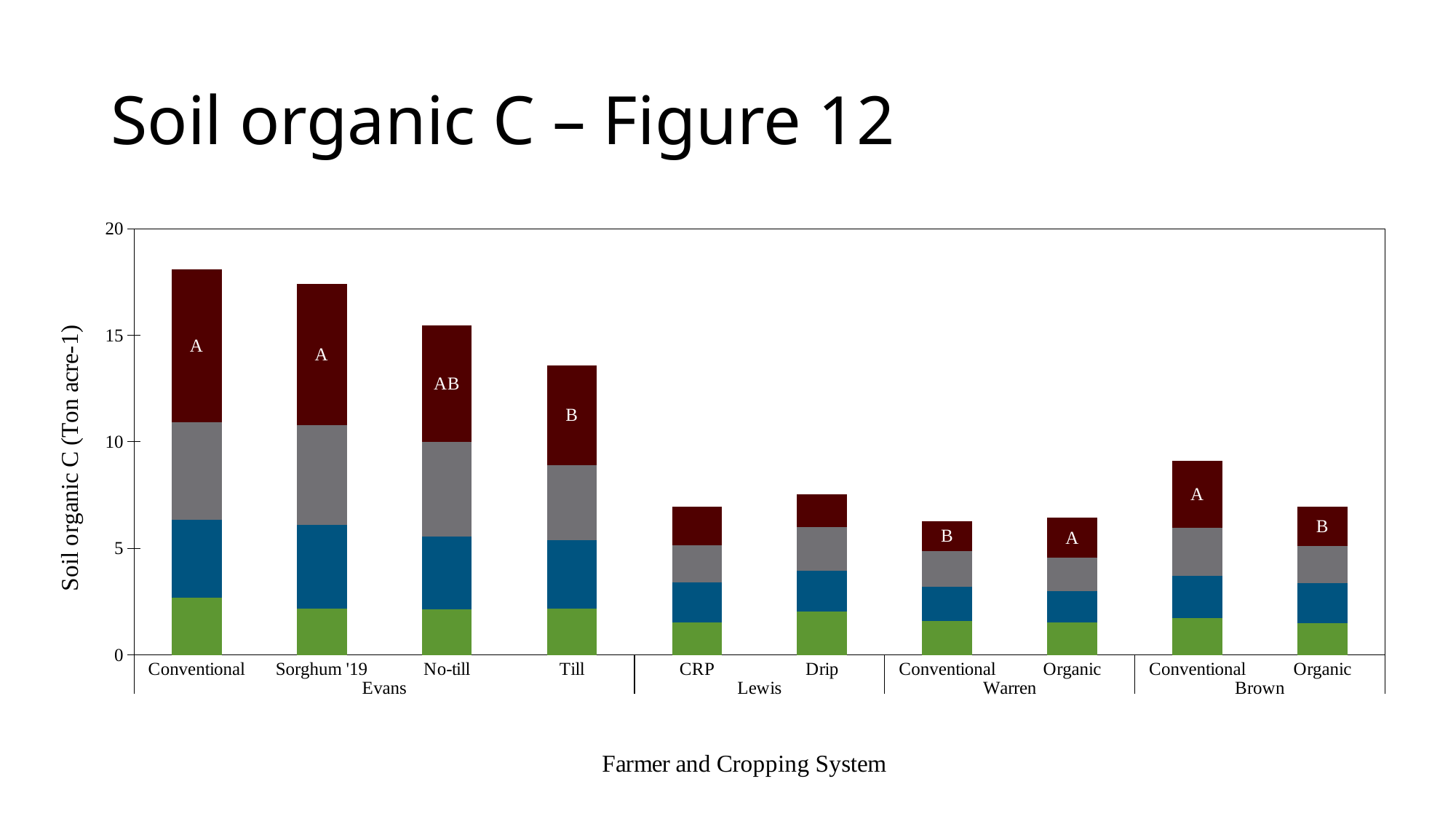
Is the total for Brown Conventional greater or less than 10? less Which bar has the highest total soil organic C? Evans Conventional Is the total for Evans Conventional greater or less than 15? greater Which is larger, the total for Brown Conventional or Brown Organic? Brown Conventional Is the total for Lewis CRP greater or less than 5? greater How many farmer groups are shown along the x axis? 4 Within the Evans group, do the bar totals rise or fall from left to right? fall What is the y-axis title of the chart? Soil organic C (Ton acre-1) Which is larger, the total for Evans Conventional or Evans Till? Evans Conventional What kind of chart is shown on the slide? Stacked bar chart How many bars are plotted in the chart? 10